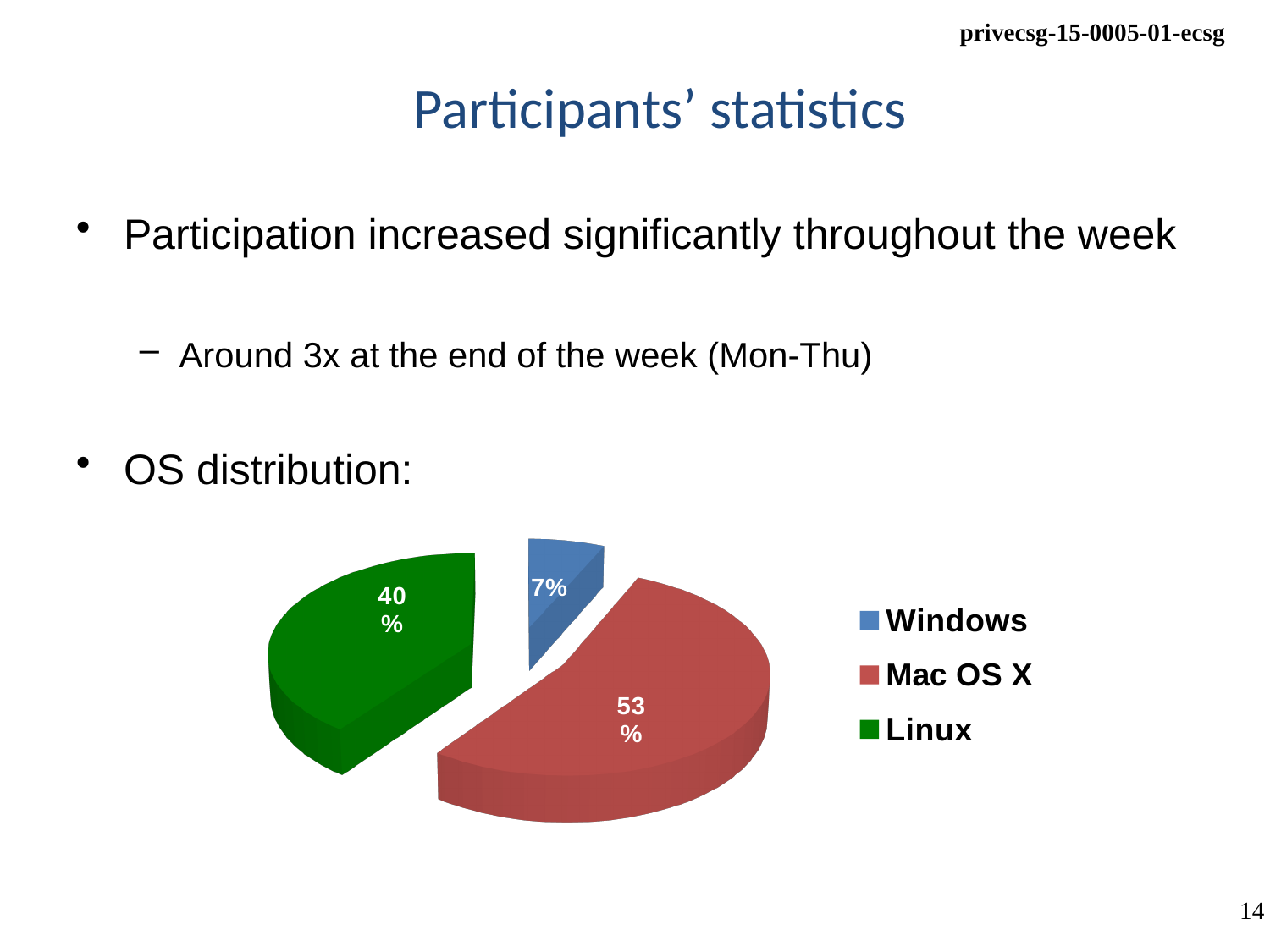
What is the difference in percentage points between the Linux and Windows slices? 33 Which slice is larger, Mac OS X or Linux? Mac OS X Which operating system has the largest slice of the pie? Mac OS X How many categories does the pie chart show? 3 What is the difference in percentage points between the Mac OS X and Linux slices? 13 What colour is the Linux slice in the pie chart? Green What share of the pie does Mac OS X have? 53% Which slice is larger, Linux or Windows? Linux What kind of chart is shown on the slide? Pie chart Which operating system has the smallest slice of the pie? Windows What share of the pie does Linux have? 40% What share of the pie does Windows have? 7%